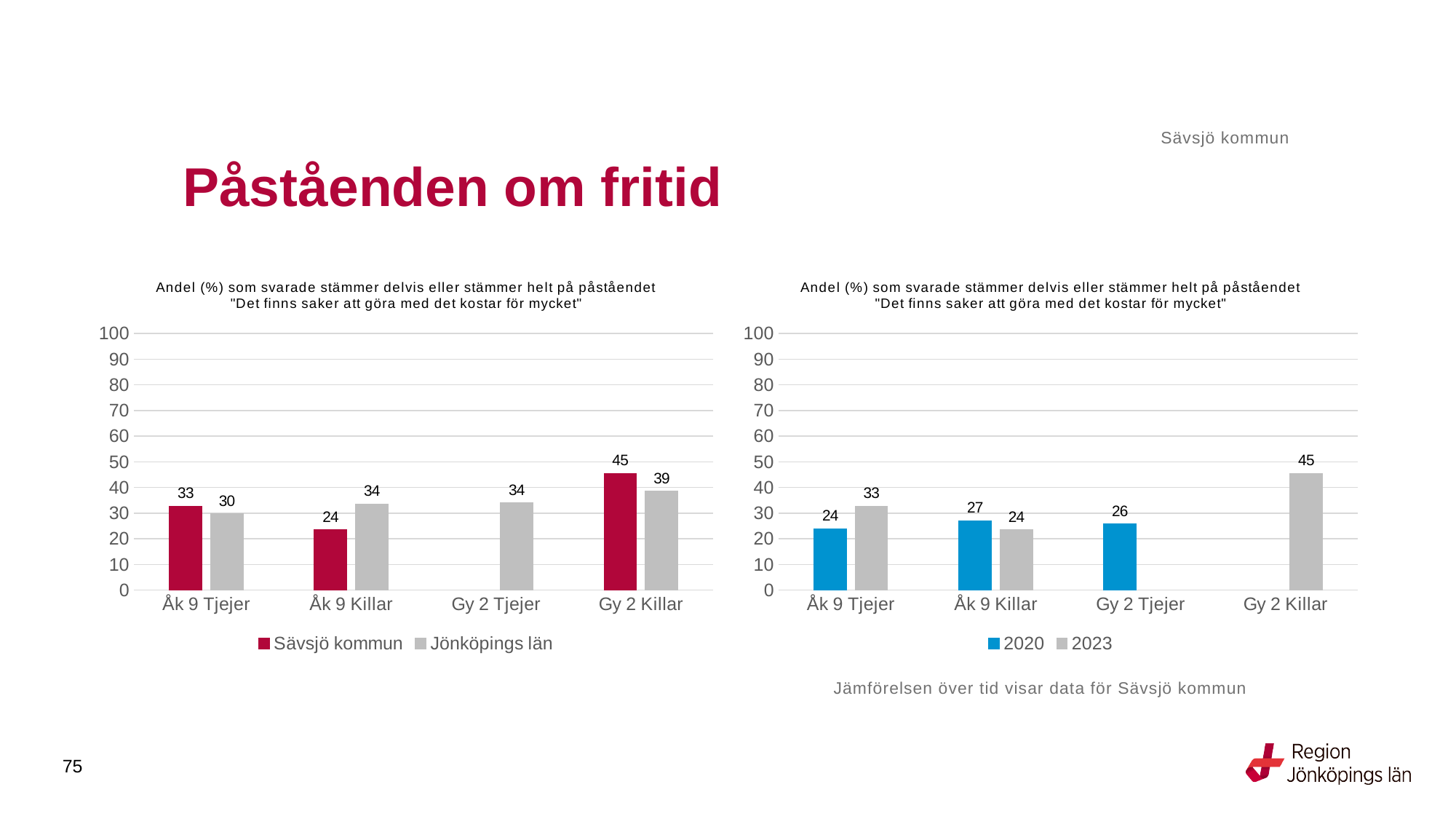
In the right chart, which category has the highest value for 2023? Gy 2 Killar In the left chart, which is larger for Gy 2 Killar: Sävsjö kommun or Jönköpings län? Sävsjö kommun In the right chart, what is the difference between 2020 and 2023 for Åk 9 Killar? 3 In the right chart, what is the value for 2020 for Gy 2 Tjejer? 26 In the left chart, what is the value for Jönköpings län for Gy 2 Killar? 39 In the left chart, which category has the lowest value for Jönköpings län? Åk 9 Tjejer What type of chart is the left chart? Bar chart In the left chart, what is the value for Sävsjö kommun for Åk 9 Tjejer? 33 In the right chart, what is the value for 2023 for Åk 9 Tjejer? 33 In the left chart, what is the difference between Sävsjö kommun and Jönköpings län for Åk 9 Killar? 10 In the left chart, which category has the highest value for Sävsjö kommun? Gy 2 Killar How many series does the legend of the right chart list? 2